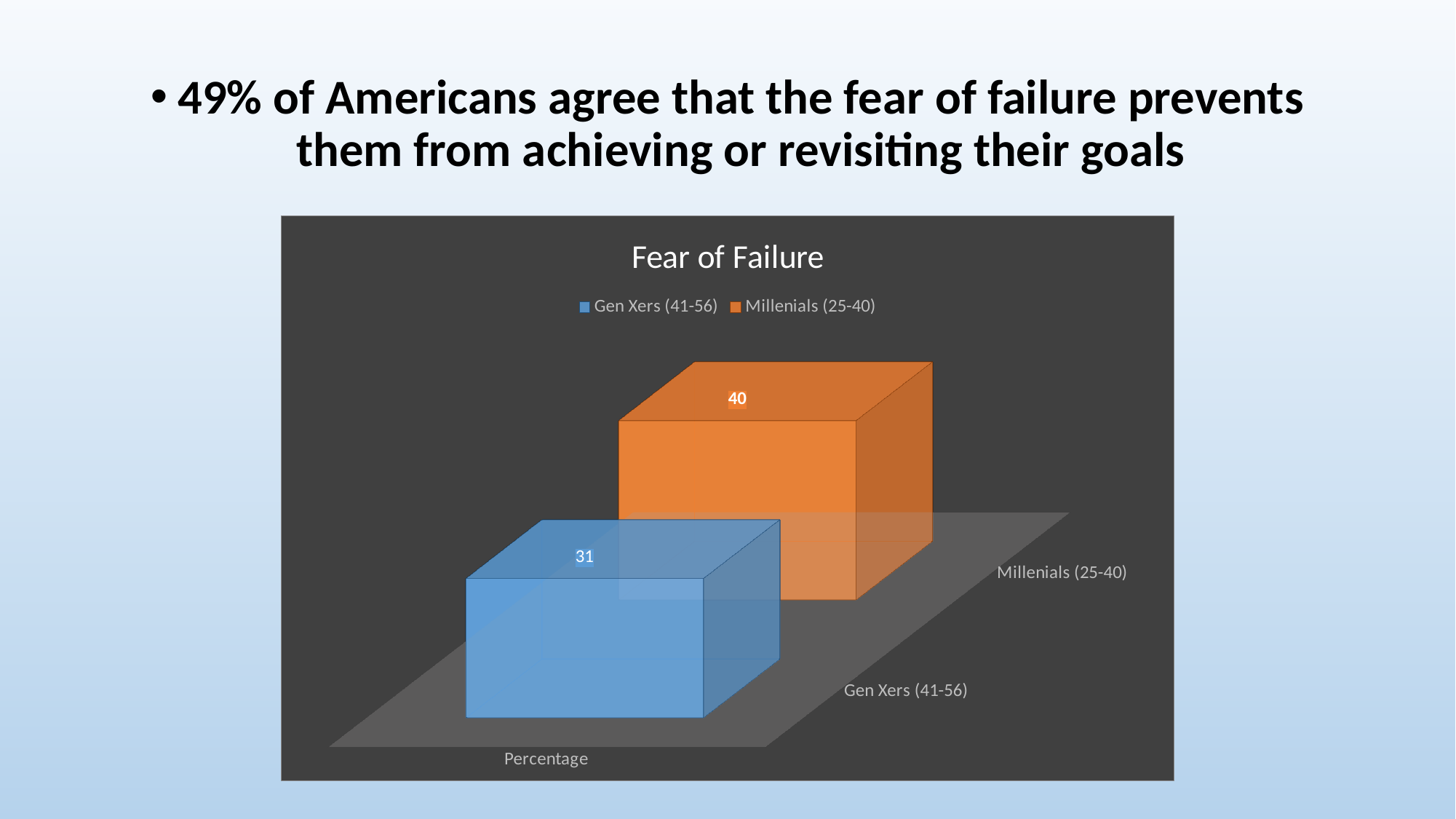
What is the value for Millenials (25-40) in the Fear of Failure chart? 40 What kind of chart is shown on the slide? Bar chart Which group has the lowest value in the Fear of Failure chart? Gen Xers (41-56) Which group has the highest value in the Fear of Failure chart? Millenials (25-40) What colour is the bar for Millenials (25-40) in the Fear of Failure chart? Orange How many bars are plotted in the Fear of Failure chart? 2 What is the title of the chart on the slide? Fear of Failure Which is larger: the value for Gen Xers (41-56) or the value for Millenials (25-40)? Millenials (25-40) What is the difference between the values for Millenials (25-40) and Gen Xers (41-56)? 9 How many series does the legend of the Fear of Failure chart list? 2 What is the value for Gen Xers (41-56) in the Fear of Failure chart? 31